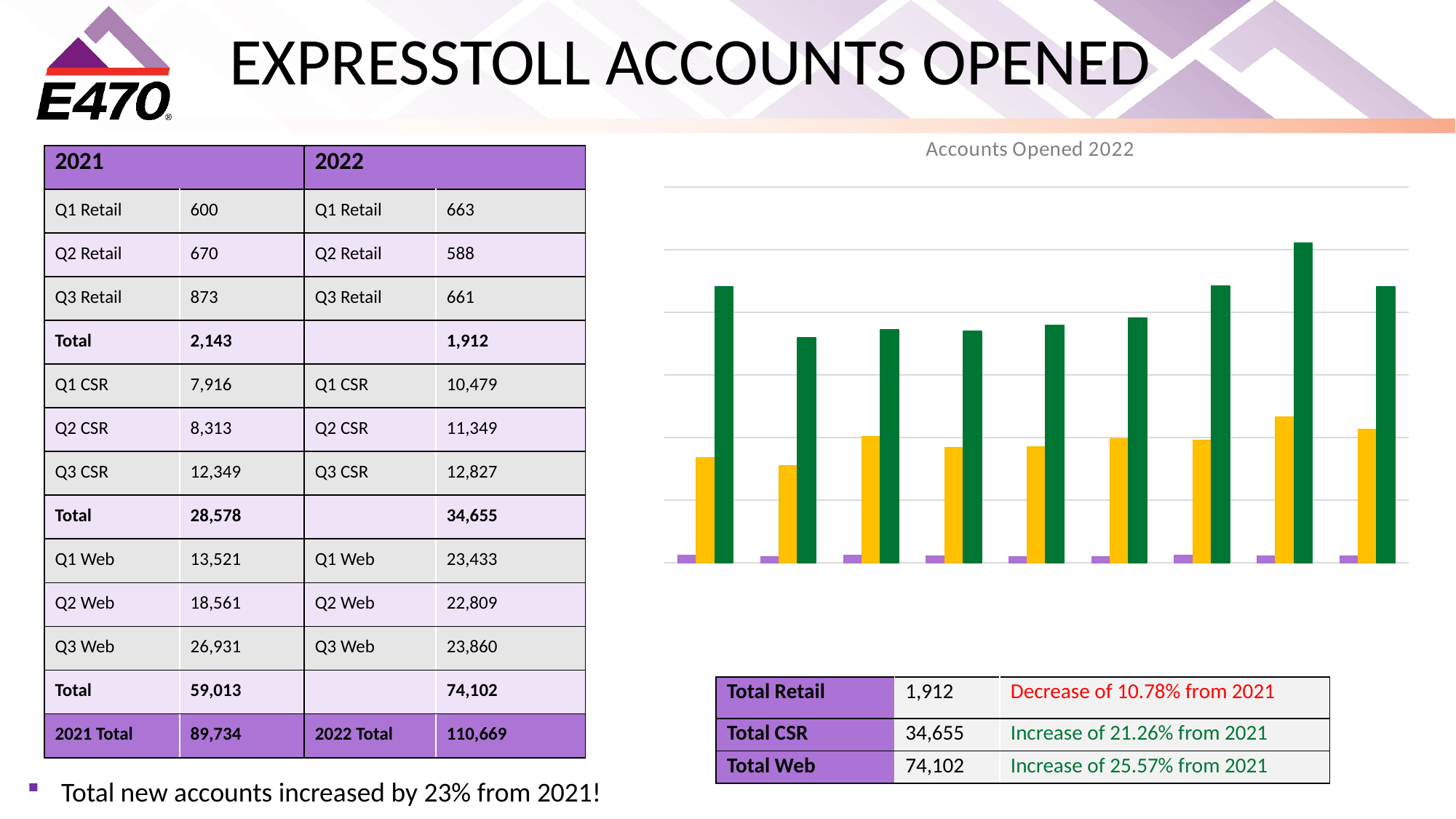
What three colours are the bars in the chart? Purple, yellow and green In the chart, which group (counting from the left) contains the tallest green bar? The eighth group What is the title of the chart on the slide? Accounts Opened 2022 How many bars are there in each group of the chart? 3 In the chart, which colour of bar is the tallest in every group? Green In the chart, is the yellow bar in the eighth group taller or shorter than the yellow bar in the second group? Taller In the chart, is the green bar in the first group taller or shorter than the green bar in the second group? Taller What kind of chart is shown on the slide? Bar chart In the chart, which colour of bar is the shortest in every group? Purple How many groups of bars does the chart show? 9